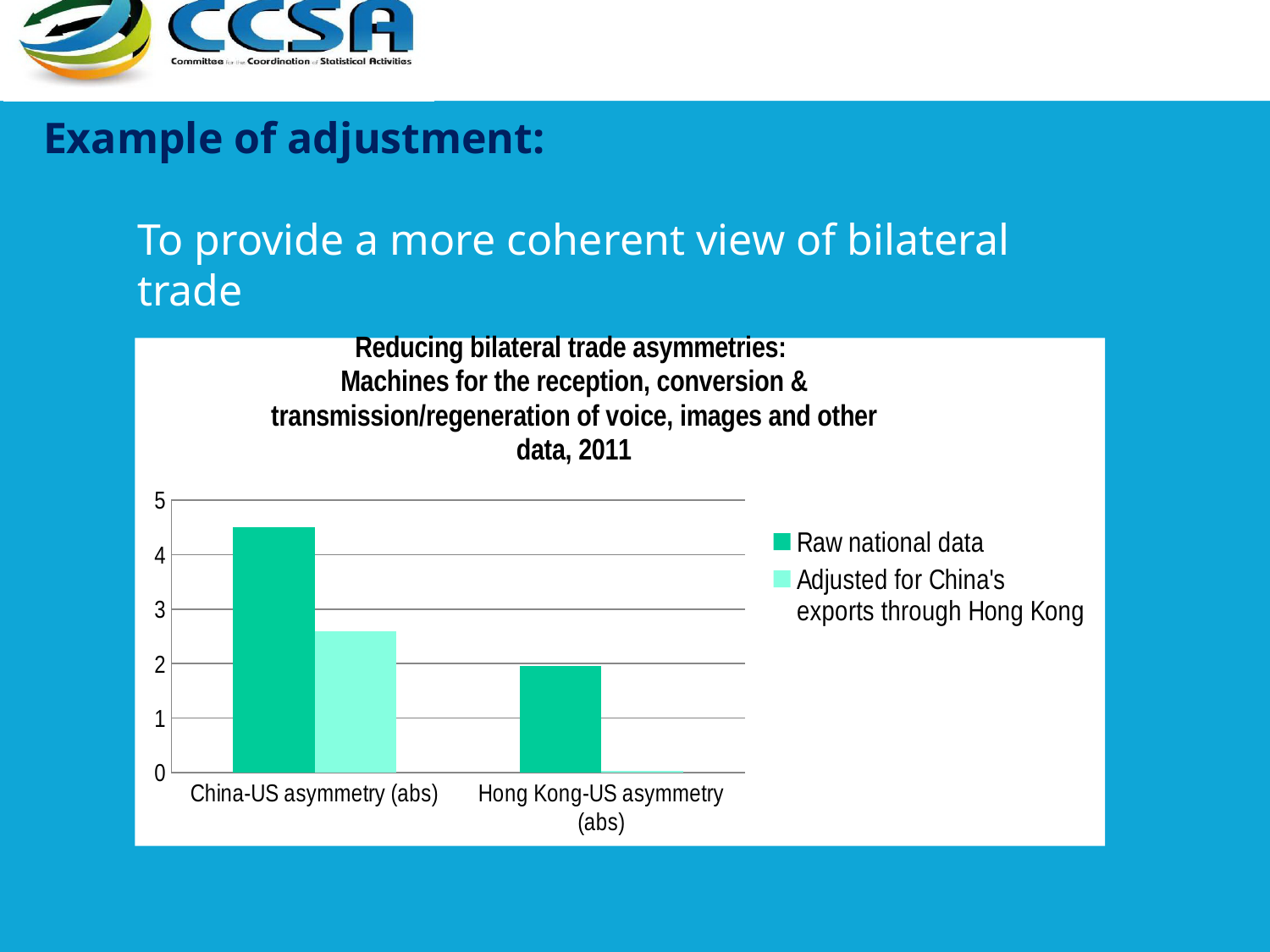
How many categories are shown on the x axis? 2 Is the Adjusted for China's exports through Hong Kong value for China-US asymmetry (abs) greater or less than 3? less Is the Raw national data value for Hong Kong-US asymmetry (abs) greater or less than 1? greater Which category has the highest Raw national data value? China-US asymmetry (abs) For China-US asymmetry (abs), which is larger: Raw national data or Adjusted for China's exports through Hong Kong? Raw national data What year is given in the chart title? 2011 How many series does the legend list? 2 Is the Raw national data value for China-US asymmetry (abs) greater or less than 4? greater What kind of chart is shown on the slide? bar chart Which category has the lowest value for Adjusted for China's exports through Hong Kong? Hong Kong-US asymmetry (abs) Which series is shown in the darker green colour? Raw national data